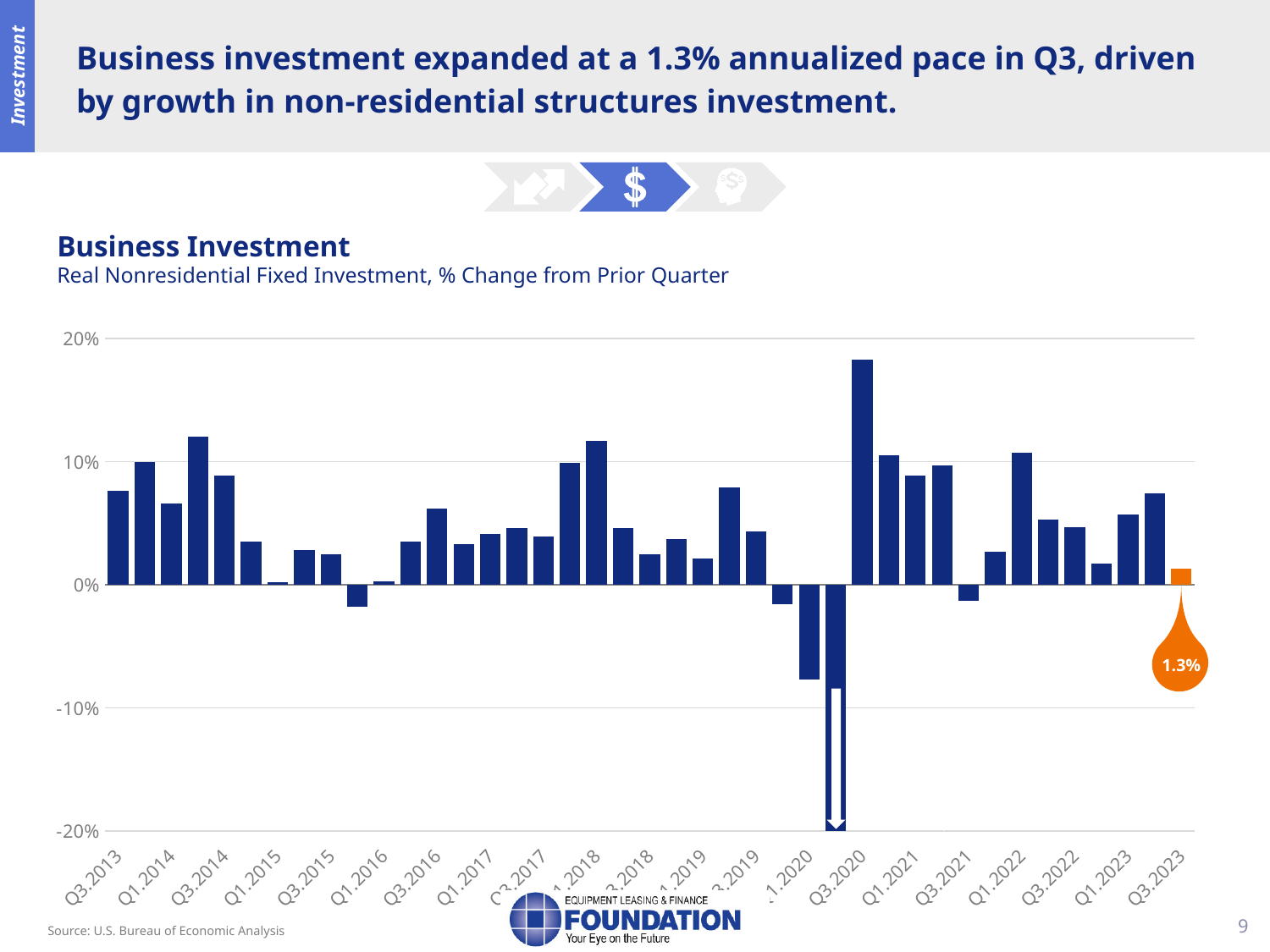
Which is larger, the value for Q3.2020 or the value for Q3.2023? Q3.2020 What is the value shown for Q3.2023? 1.3% What colour is the bar for Q3.2023? orange What is the title of the chart? Business Investment Is the value for Q1.2020 greater or less than -10%? greater Which labeled quarter has the highest value? Q3.2020 What kind of chart is shown on the slide? bar chart Is the value for Q3.2020 greater or less than 10%? greater Is the value for Q3.2021 greater or less than 0%? less Which is larger, the value for Q3.2013 or the value for Q3.2023? Q3.2013